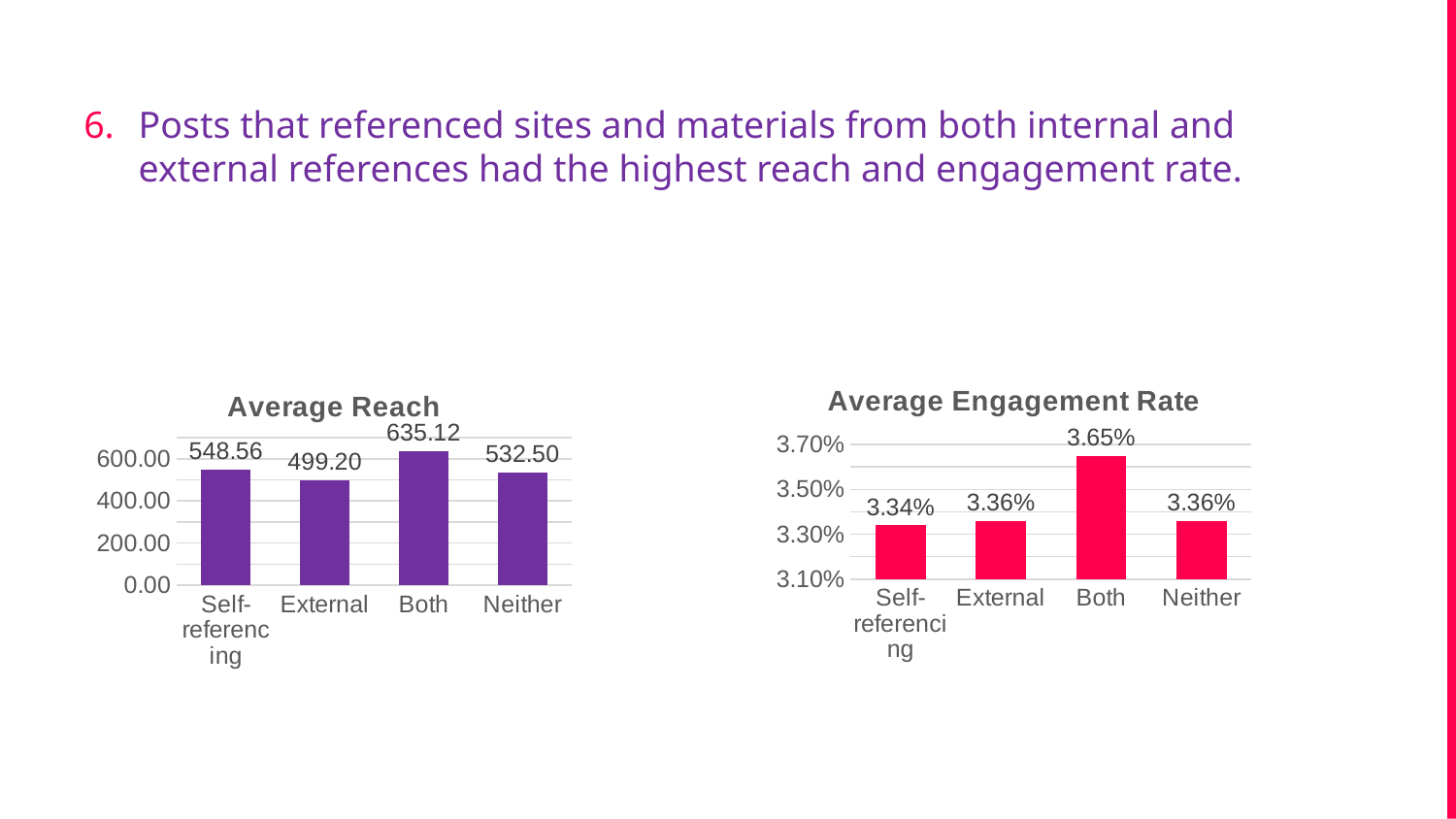
In the Average Reach chart, which category has the lowest value? External What kind of chart is the Average Engagement Rate chart? Bar chart In the Average Reach chart, how many categories are shown? 4 In the Average Engagement Rate chart, what is the value for Self-referencing? 3.34% In the Average Reach chart, which is larger, Self-referencing or Neither? Self-referencing In the Average Engagement Rate chart, what is the difference between Both and External? 0.29% In the Average Reach chart, what is the value for Both? 635.12 In the Average Reach chart, what is the value for External? 499.20 In the Average Engagement Rate chart, which category has the highest value? Both What colour are the bars in the Average Reach chart? Purple In the Average Reach chart, what is the difference between Both and Self-referencing? 86.56 In the Average Engagement Rate chart, what is the value for Both? 3.65%